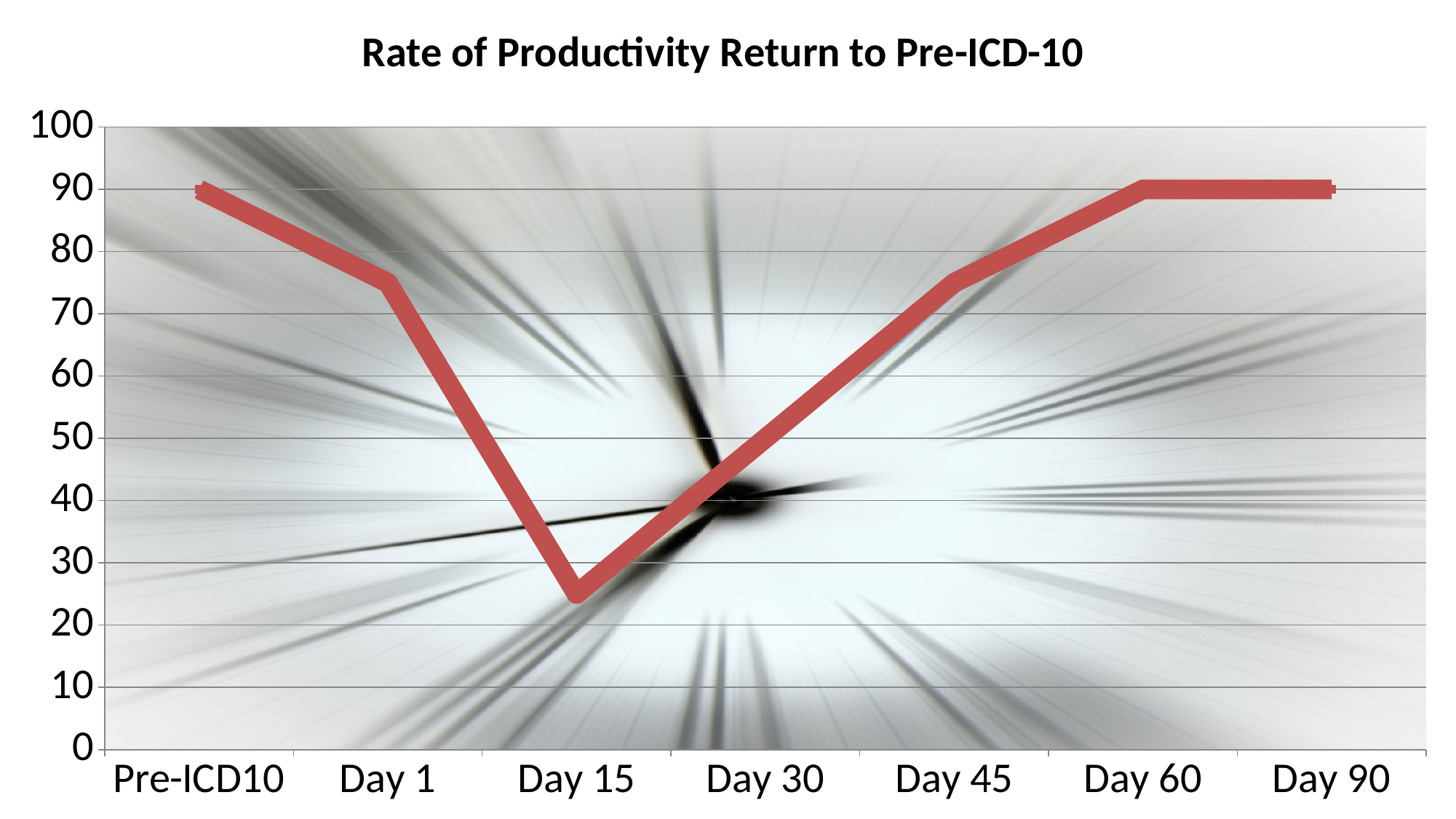
What is the value for Day 90? 90 Is the value for Day 1 greater or less than 70? greater What is the value for Pre-ICD10? 90 Is the value for Day 15 greater or less than 30? less Do the values rise or fall from Day 15 to Day 60? rise Which is larger, the value for Day 1 or the value for Day 15? Day 1 Which category has the lowest value? Day 15 What is the title of the chart? Rate of Productivity Return to Pre-ICD-10 How many categories are plotted along the x axis? 7 What kind of chart is shown on the slide? line chart Is the value for Day 45 greater or less than 70? greater